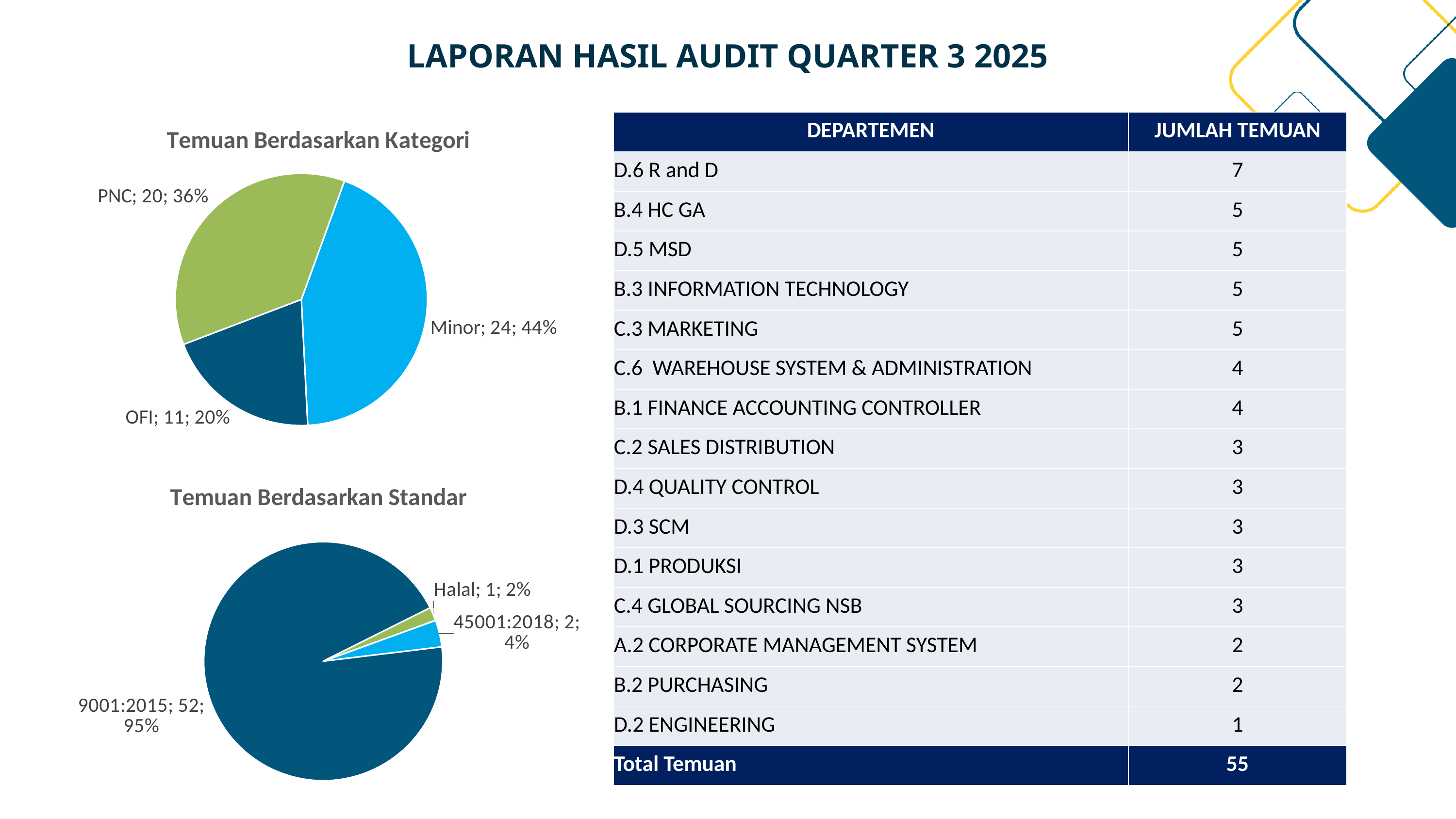
In the 'Temuan Berdasarkan Standar' chart, which standard has the lowest value? Halal In the 'Temuan Berdasarkan Standar' chart, what is the value for 9001:2015? 52 What kind of chart is 'Temuan Berdasarkan Standar'? Pie chart In the 'Temuan Berdasarkan Kategori' chart, how many categories are shown? 3 In the 'Temuan Berdasarkan Standar' chart, which is larger, 45001:2018 or Halal? 45001:2018 In the 'Temuan Berdasarkan Kategori' chart, what share of the pie does PNC represent? 36% In the 'Temuan Berdasarkan Kategori' chart, what is the value for Minor? 24 In the 'Temuan Berdasarkan Standar' chart, what share of the pie does 45001:2018 represent? 4% In the 'Temuan Berdasarkan Kategori' chart, what is the difference between the Minor and OFI values? 13 In the 'Temuan Berdasarkan Kategori' chart, what colour is the PNC slice? Green In the 'Temuan Berdasarkan Kategori' chart, which category has the lowest value? OFI In the 'Temuan Berdasarkan Kategori' chart, which category has the highest value? Minor